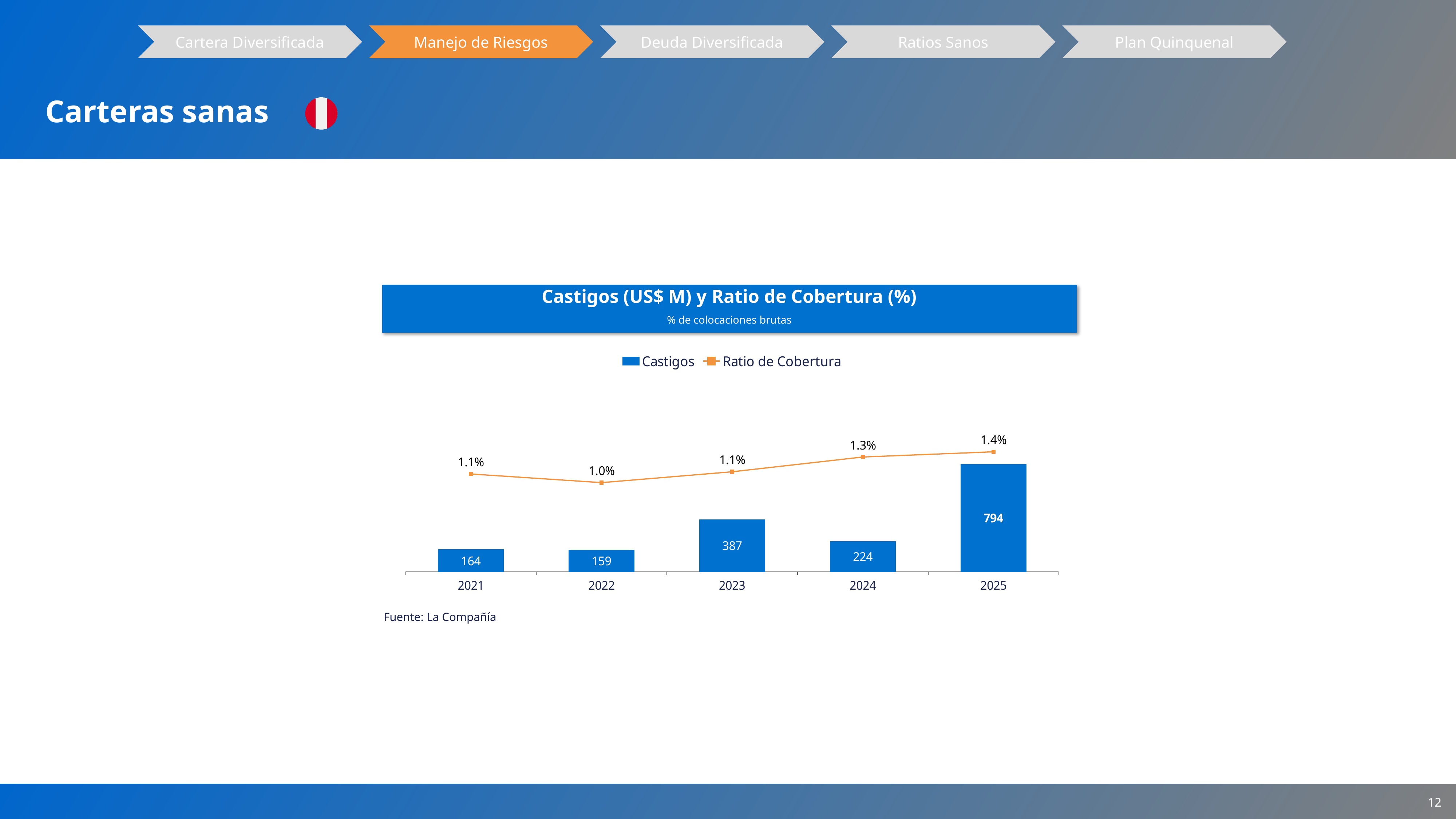
How many series does the legend list? 2 What kind of chart is used for the Castigos series? Bar chart Which year has the highest Castigos value? 2025 What is the difference between the Castigos values for 2025 and 2024? 570 Which is larger, the Castigos value for 2023 or for 2024? 2023 How many years are shown on the x axis? 5 Which year has the lowest Castigos value? 2022 Which year has the lowest Ratio de Cobertura? 2022 What is the Castigos value for 2023? 387 What is the Castigos value for 2021? 164 What is the Ratio de Cobertura for 2024? 1.3% What is the title of the chart? Castigos (US$ M) y Ratio de Cobertura (%)